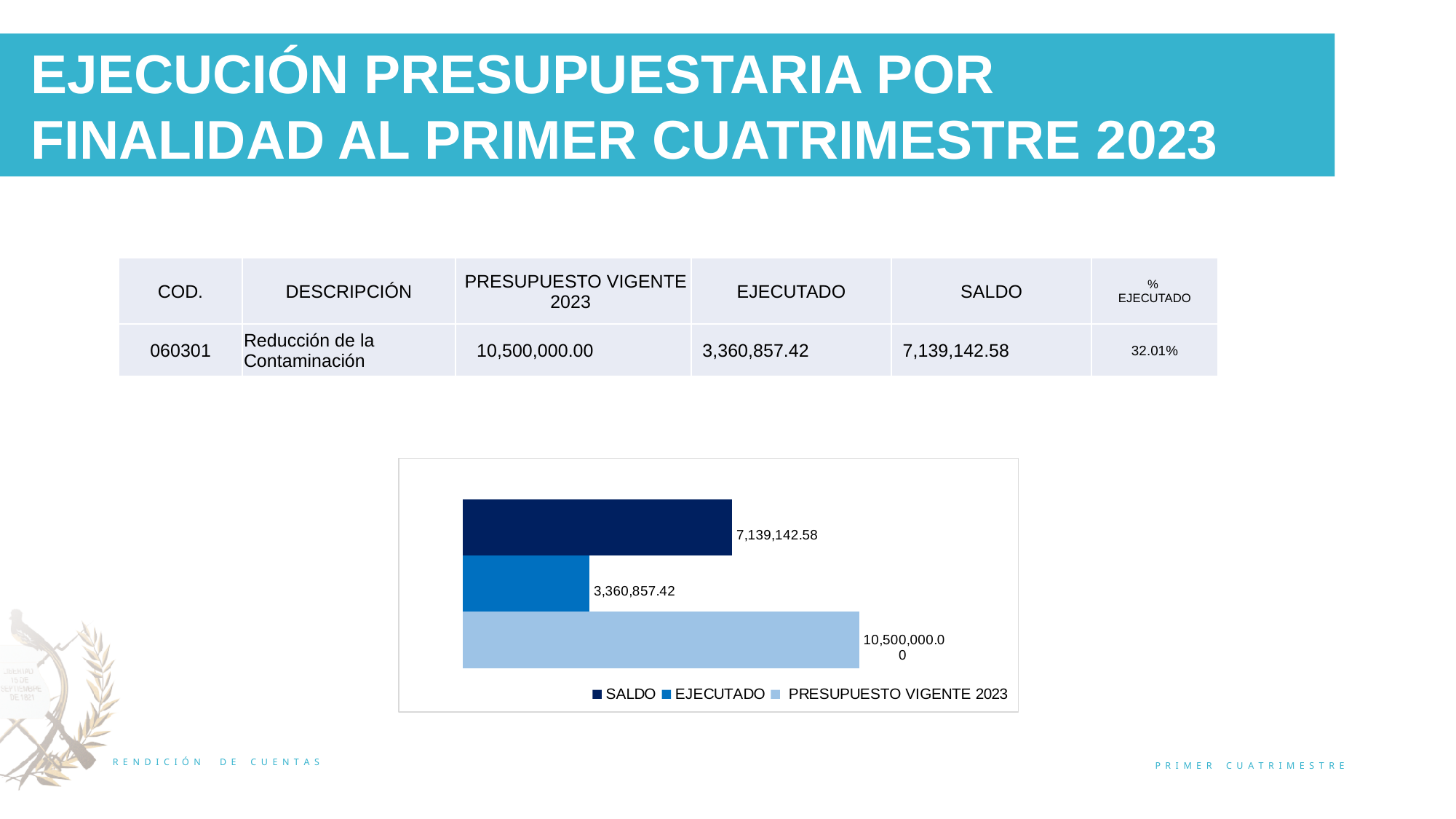
Which is larger in the chart, SALDO or EJECUTADO? SALDO Which series has the lowest value in the chart? EJECUTADO What is the value of the PRESUPUESTO VIGENTE 2023 bar in the chart? 10,500,000.00 How many bars are plotted in the chart? 3 What is the difference between the PRESUPUESTO VIGENTE 2023 and SALDO values in the chart? 3,360,857.42 What is the value of the EJECUTADO bar in the chart? 3,360,857.42 What is the difference between the SALDO and EJECUTADO values in the chart? 3,778,285.16 How many series does the chart legend list? 3 Which series in the chart is drawn in the darkest blue? SALDO Which series has the highest value in the chart? PRESUPUESTO VIGENTE 2023 What is the value of the SALDO bar in the chart? 7,139,142.58 What kind of chart is shown on the slide? bar chart